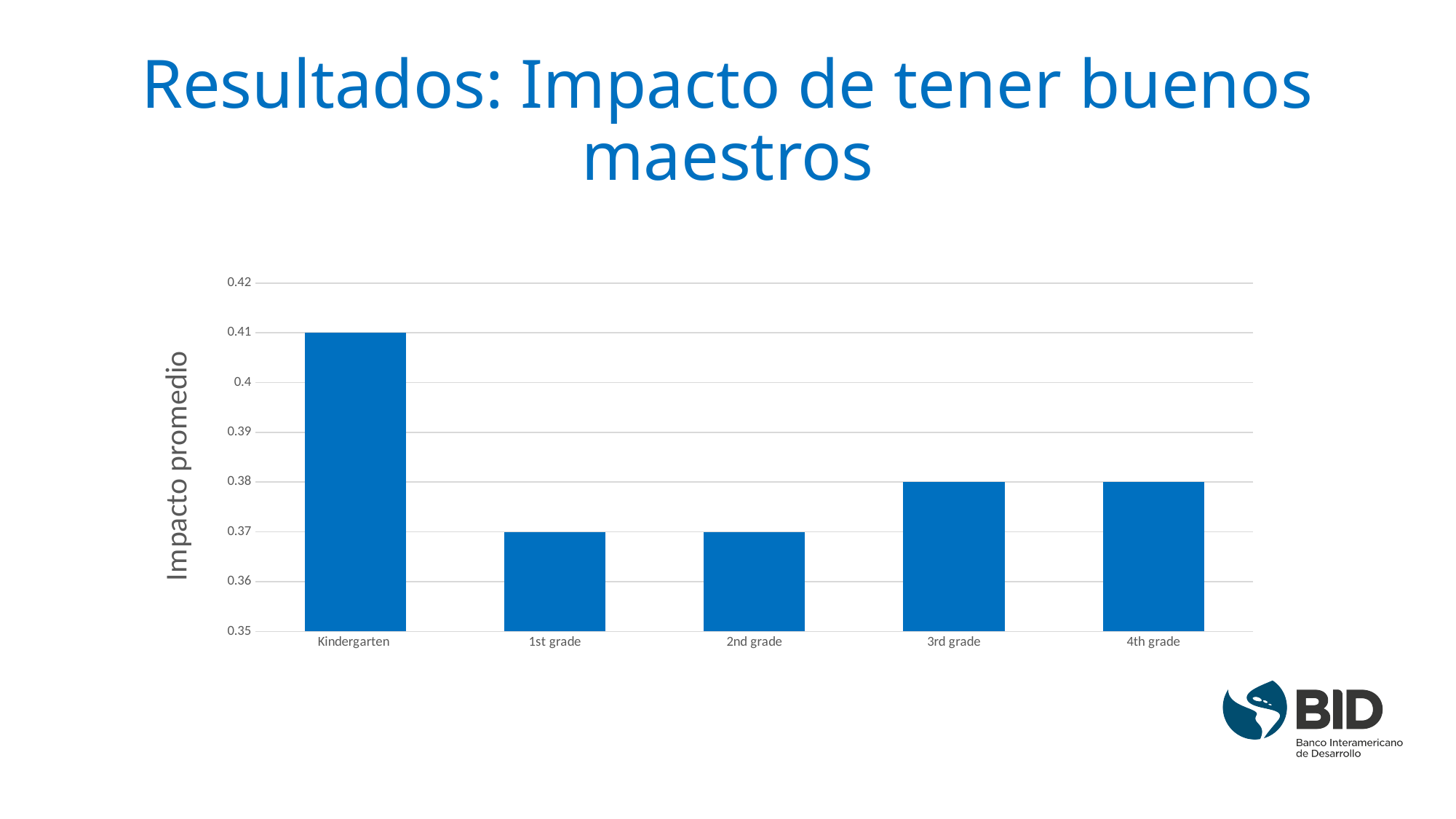
What is the value for Kindergarten? 0.41 What is the label on the vertical axis of the chart? Impacto promedio What is the value for 4th grade? 0.38 How many categories are shown on the x axis? 5 What is the value for 1st grade? 0.37 Which is larger, the value for Kindergarten or the value for 3rd grade? Kindergarten What is the difference between the values for 3rd grade and 2nd grade? 0.01 What is the value for 3rd grade? 0.38 Which category has the highest value? Kindergarten What kind of chart is shown on the slide? bar chart What is the difference between the values for Kindergarten and 1st grade? 0.04 Is the value for 2nd grade greater or less than 0.38? less